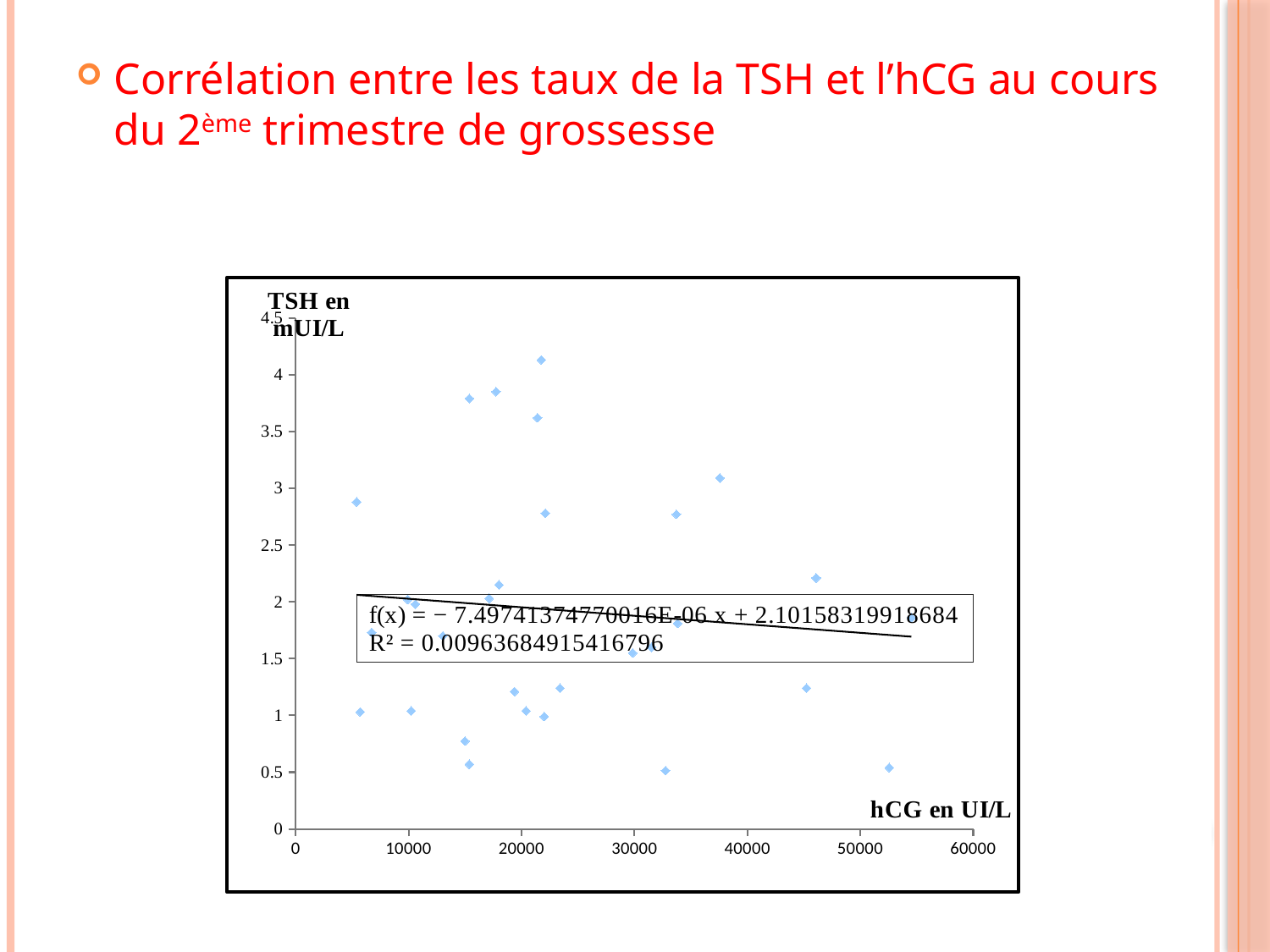
What is the highest tick value shown on the vertical axis? 4.5 What is the slope of the fitted line f(x) printed on the chart? − 7.49741374770016E-06 What is the intercept of the fitted line f(x) printed on the chart? 2.10158319918684 According to the fitted trendline, do TSH values rise or fall as hCG increases? fall What is the R² value printed on the chart? 0.00963684915416796 What kind of chart is shown on the slide? scatter plot Is the largest hCG value plotted greater or less than 50000? greater What is the highest tick value shown on the horizontal axis? 60000 What is the label of the horizontal axis? hCG en UI/L Is the lowest TSH value plotted greater or less than 1? less What is the label of the vertical axis? TSH en mUI/L Is the highest TSH value plotted greater or less than 4? greater